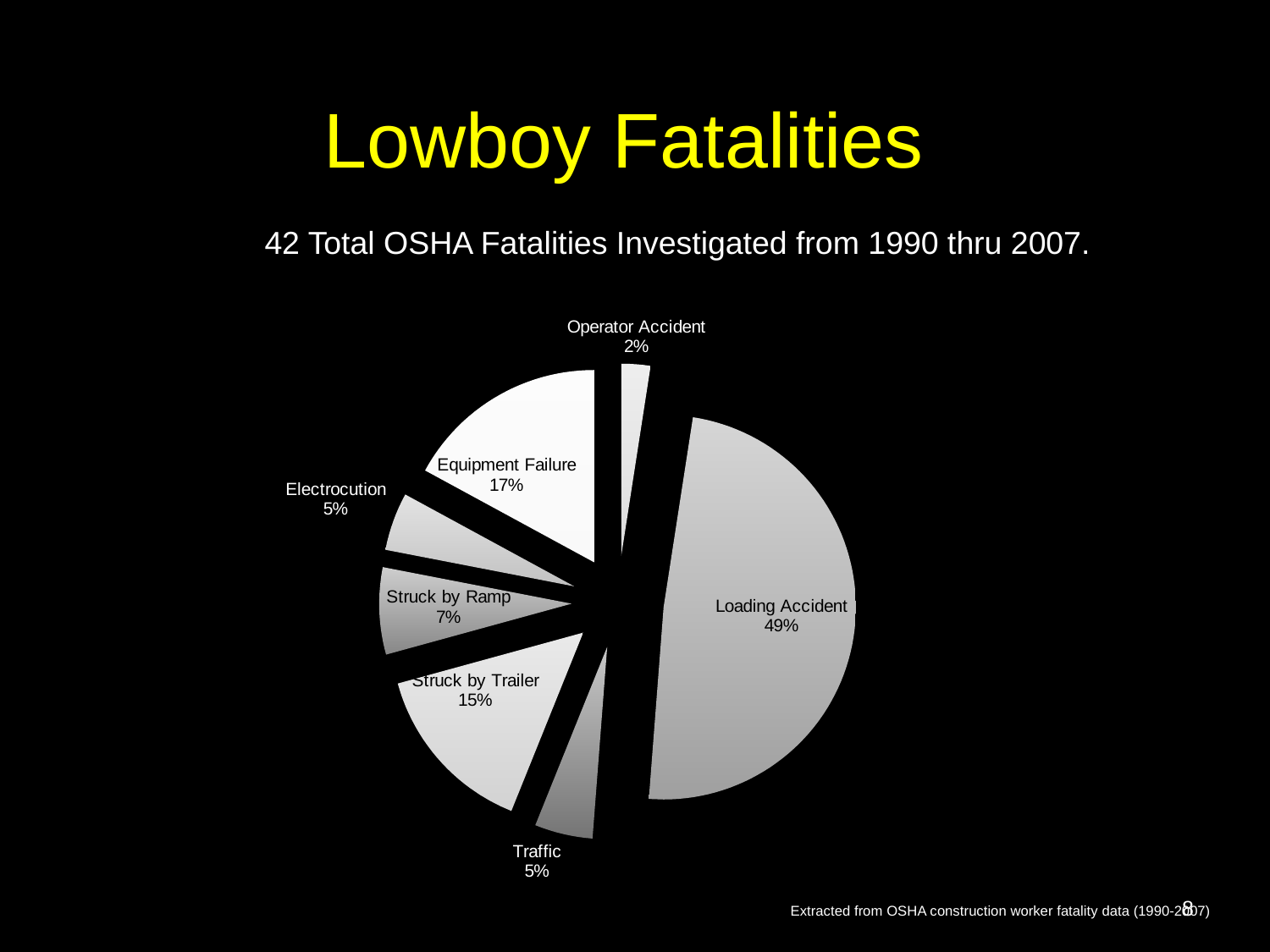
Which category has the smallest slice of the pie? Operator Accident What share of lowboy fatalities is attributed to Loading Accident? 49% What percentage of fatalities is labelled Operator Accident? 2% What percentage of fatalities is labelled Equipment Failure? 17% What kind of chart is shown on the slide? pie chart What percentage of fatalities is labelled Struck by Ramp? 7% How many categories are shown in the pie chart? 7 How many total OSHA fatalities does the slide say were investigated from 1990 thru 2007? 42 Which category has the largest slice of the pie? Loading Accident What percentage of fatalities is labelled Struck by Trailer? 15% What is the difference in percentage points between Equipment Failure and Struck by Trailer? 2 Which is larger, the share for Struck by Ramp or the share for Electrocution? Struck by Ramp